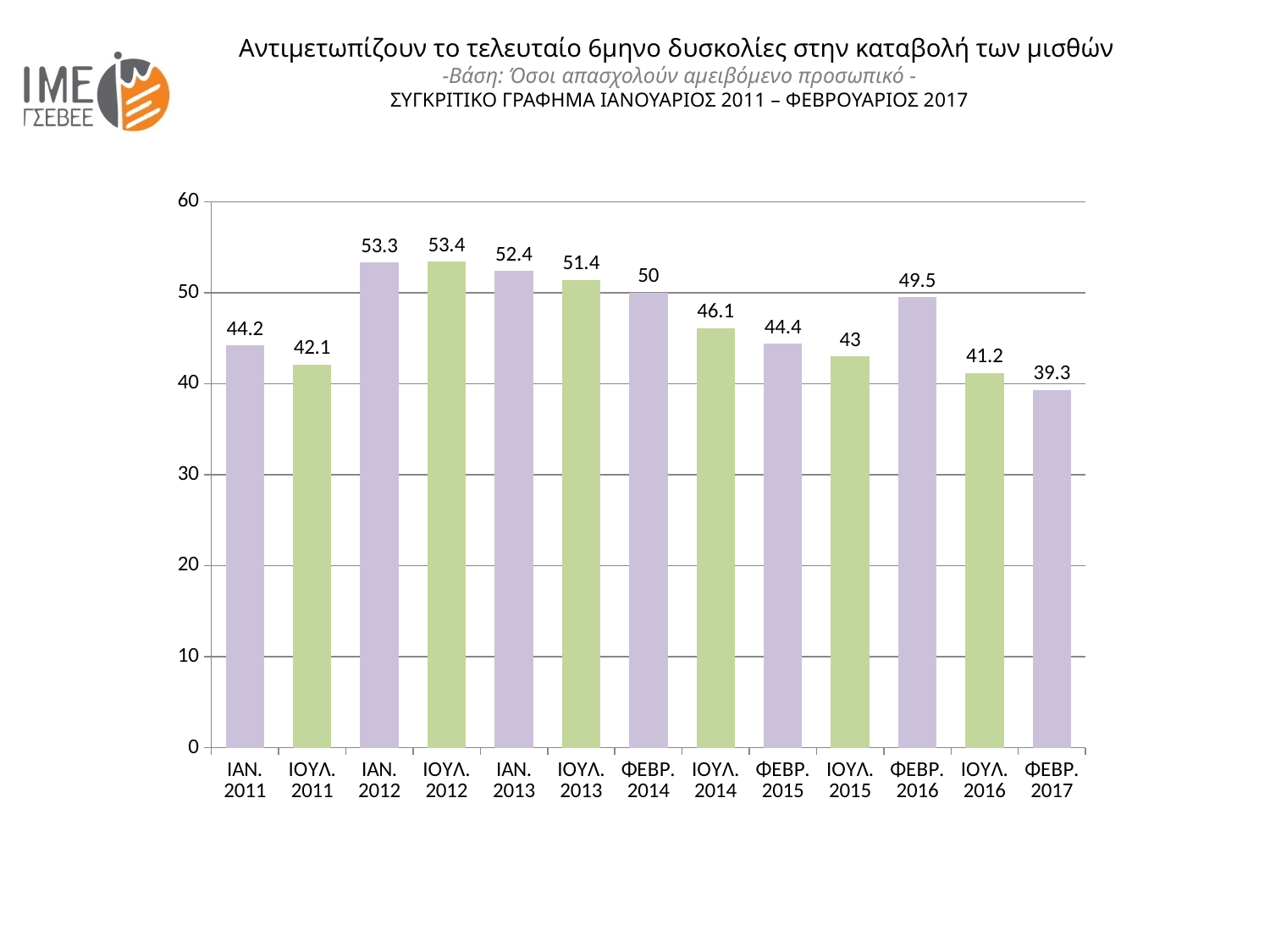
Which period has the highest value? ΙΟΥΛ. 2012 What is the value for ΦΕΒΡ. 2017? 39.3 What is the value for ΙΑΝ. 2011? 44.2 What is the value for ΙΟΥΛ. 2013? 51.4 Is the value for ΙΟΥΛ. 2015 greater or less than 40? greater Which is larger, the value for ΦΕΒΡ. 2014 or the value for ΙΟΥΛ. 2014? ΦΕΒΡ. 2014 How many periods are shown on the x axis? 13 What is the difference between the values for ΙΑΝ. 2012 and ΙΟΥΛ. 2011? 11.2 Which period has the lowest value? ΦΕΒΡ. 2017 What kind of chart is shown on the slide? bar chart Do the values rise or fall from ΦΕΒΡ. 2016 to ΦΕΒΡ. 2017? fall What is the value for ΦΕΒΡ. 2016? 49.5